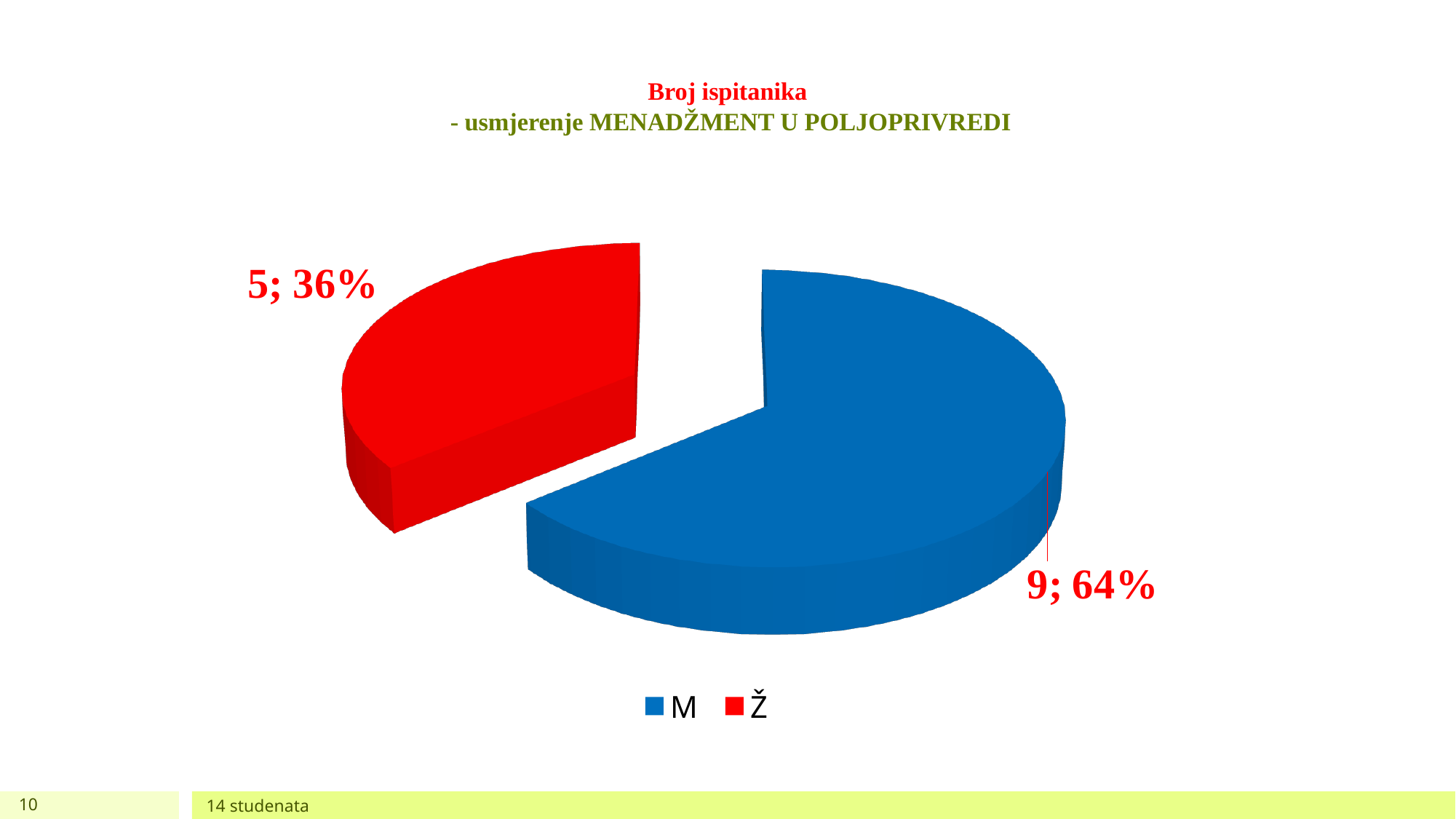
What share of the pie does the Ž slice represent? 36% Which is larger, the M slice or the Ž slice? M How many categories does the pie chart have? 2 What share of the pie does the M slice represent? 64% What type of chart is shown on the slide? pie chart What is the difference between the number of M and Ž respondents? 4 Which category has the smallest slice? Ž How many respondents are in the M category? 9 Which category has the largest slice? M What colour is the Ž slice? red What is the total number of respondents shown in the pie chart? 14 How many respondents are in the Ž category? 5